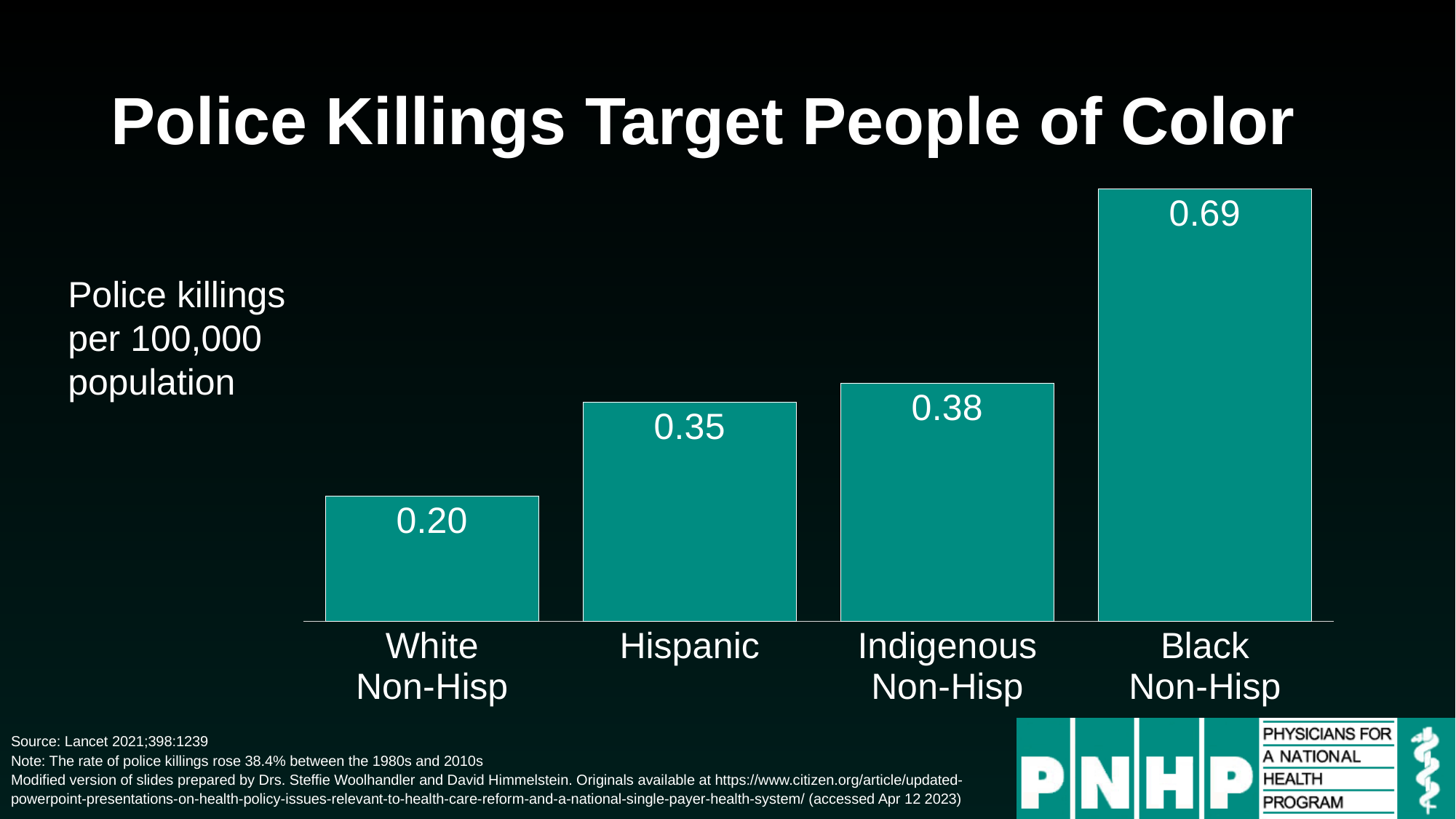
Which group has the highest rate of police killings per 100,000 population? Black Non-Hisp What is the difference between the police killing rates for Indigenous Non-Hisp and Hispanic? 0.03 What is the title of the chart on the slide? Police Killings Target People of Color What is the rate of police killings per 100,000 population for Black Non-Hisp? 0.69 What is the rate of police killings per 100,000 population for White Non-Hisp? 0.20 What is the rate of police killings per 100,000 population for Indigenous Non-Hisp? 0.38 What kind of chart is shown on the slide? Bar chart Which group has the lowest rate of police killings per 100,000 population? White Non-Hisp How many groups are shown in the chart? 4 What is the difference between the police killing rates for Black Non-Hisp and White Non-Hisp? 0.49 What is the rate of police killings per 100,000 population for Hispanic? 0.35 Which has a higher rate of police killings, Hispanic or White Non-Hisp? Hispanic